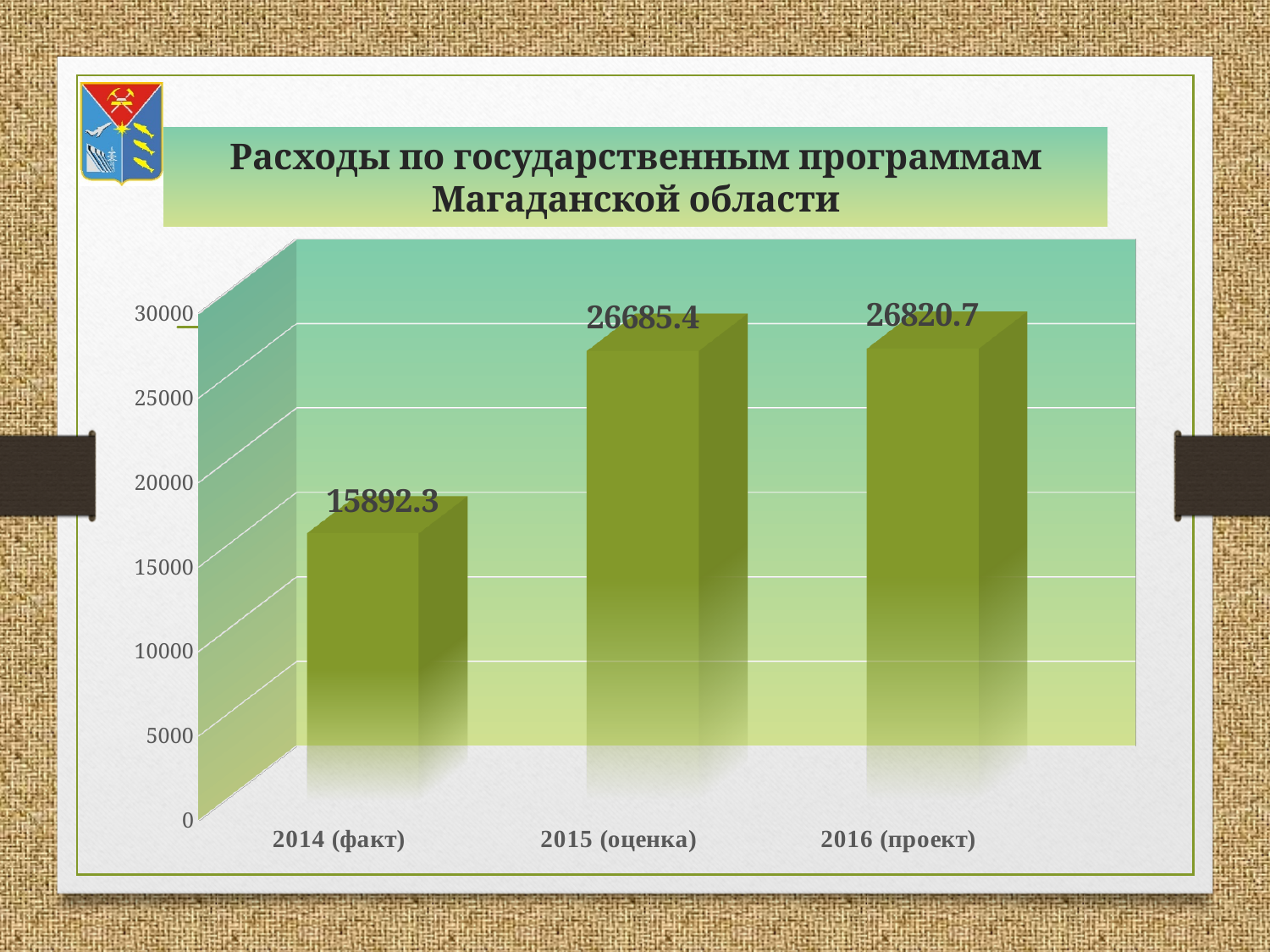
Which category has the highest value? 2016 (проект) What is the title of the chart? Расходы по государственным программам Магаданской области What is the value for 2015 (оценка)? 26685.4 What is the value for 2014 (факт)? 15892.3 What is the difference between the values for 2015 (оценка) and 2014 (факт)? 10793.1 How many categories are shown on the x axis? 3 Which category has the lowest value? 2014 (факт) What kind of chart is shown on the slide? bar chart Which is larger, the value for 2014 (факт) or the value for 2015 (оценка)? 2015 (оценка) Is the value for 2014 (факт) greater or less than 20000? less What is the value for 2016 (проект)? 26820.7 What is the difference between the values for 2016 (проект) and 2015 (оценка)? 135.3